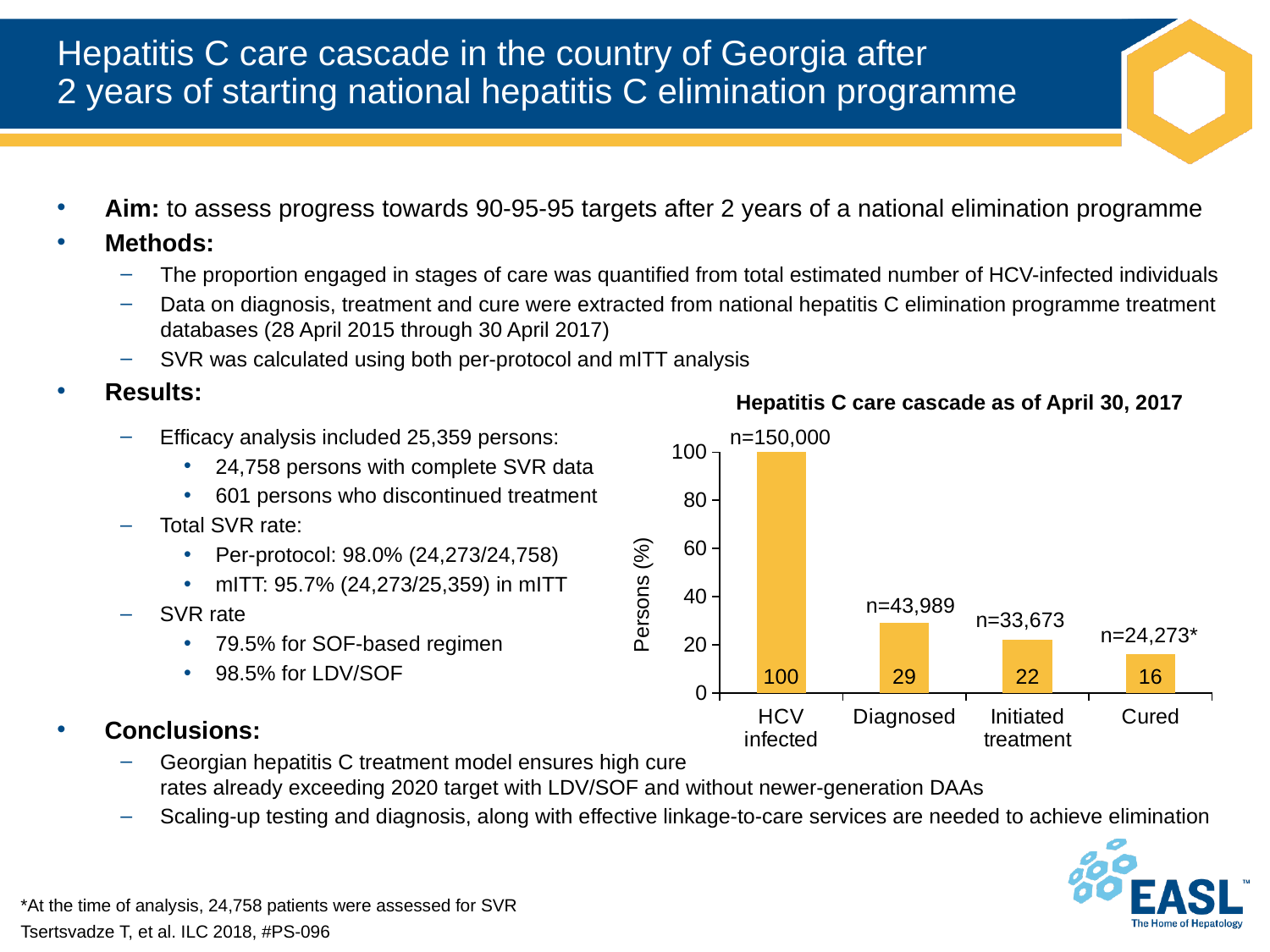
How many categories are shown on the x axis of the chart? 4 What is the value for Diagnosed in the Hepatitis C care cascade chart? 29 Which is larger, the value for Diagnosed or the value for Cured? Diagnosed What is the value for Initiated treatment in the Hepatitis C care cascade chart? 22 Which category has the highest value in the chart? HCV infected What is the difference between the values for Diagnosed and Initiated treatment? 7 Do the values rise or fall from left to right along the x axis? Fall What is the value for Cured in the Hepatitis C care cascade chart? 16 What is the n value shown above the Diagnosed bar? n=43,989 Which category has the lowest value in the chart? Cured What is the difference between the values for HCV infected and Cured? 84 What kind of chart is shown on the slide? Bar chart